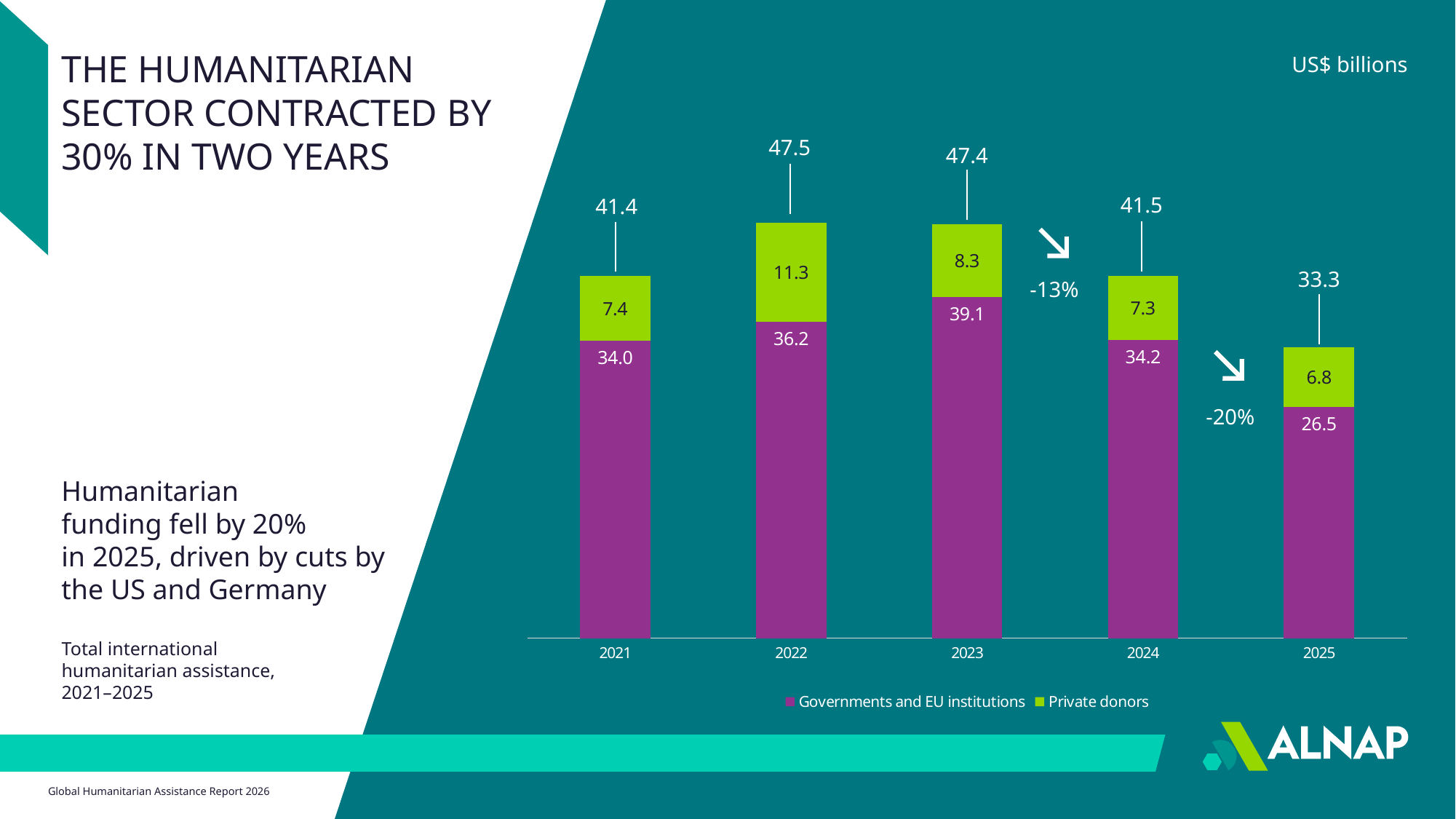
Which year has the lowest value for Private donors? 2025 Which is larger: the Private donors value in 2021 or in 2024? 2021 What is the value for Governments and EU institutions in 2023? 39.1 What is the total of the stacked bar for 2025? 33.3 Do the total values rise or fall from 2023 to 2025? Fall How many years are shown on the x axis? 5 Which year has the highest total international humanitarian assistance? 2022 What kind of chart is shown on the slide? Stacked bar chart What is the difference between the Governments and EU institutions values for 2024 and 2025? 7.7 How many series does the legend list? 2 What is the value for Private donors in 2022? 11.3 What unit is stated for the values in the chart? US$ billions